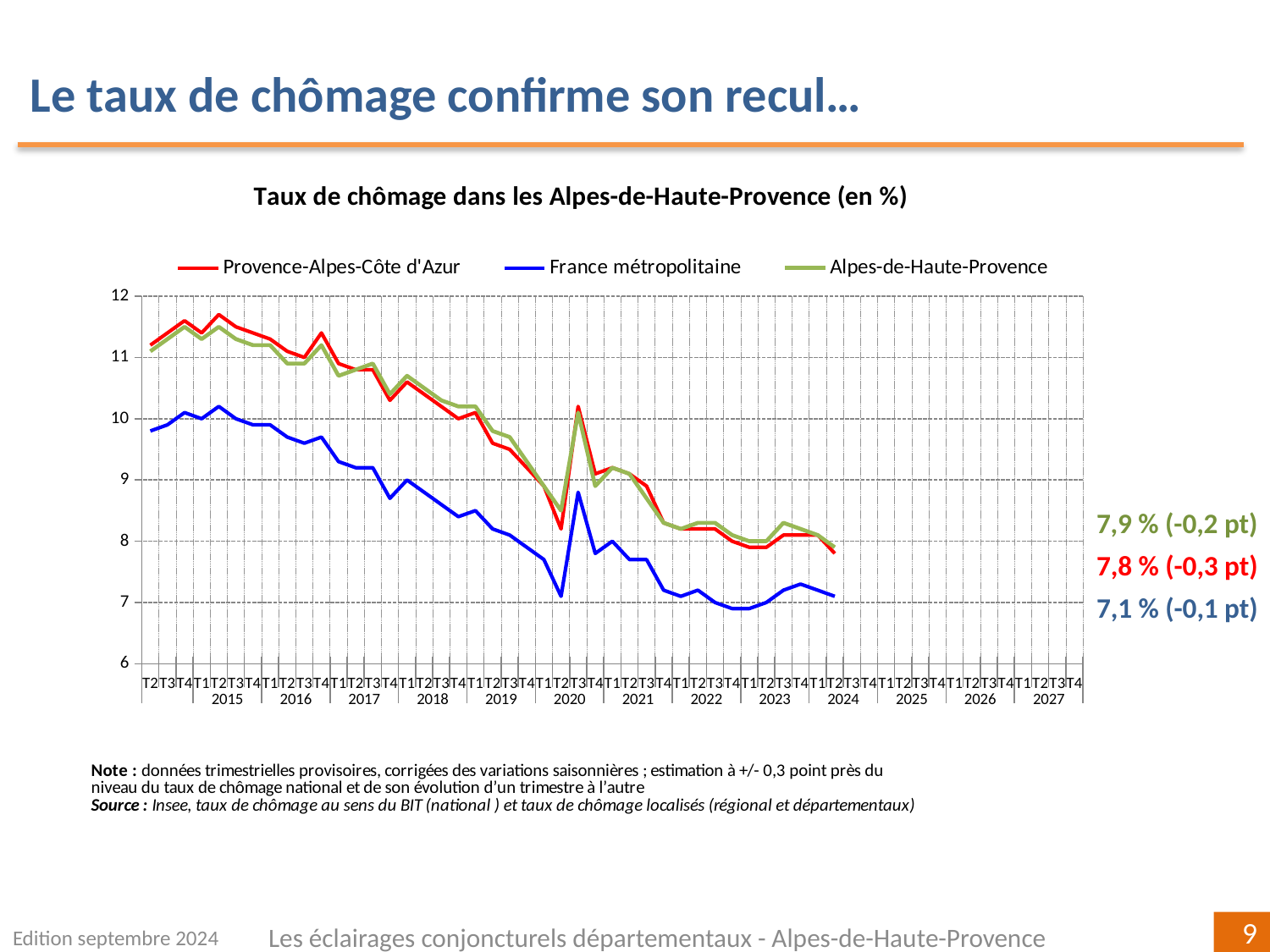
By how much did the Provence-Alpes-Côte d'Azur rate change in the latest quarter, according to the annotation? -0,3 pt Is the value for France métropolitaine in 2015 greater or less than 11? less At the latest point, which series has the higher rate: Provence-Alpes-Côte d'Azur or France métropolitaine? Provence-Alpes-Côte d'Azur What is the latest unemployment rate shown for Alpes-de-Haute-Provence? 7,9 % What is the latest unemployment rate shown for France métropolitaine? 7,1 % Overall, do the unemployment rates rise or fall from 2015 to 2024? fall Which series is the lowest across the whole period shown? France métropolitaine What kind of chart is shown on the slide? line chart What is the title of the chart? Taux de chômage dans les Alpes-de-Haute-Provence (en %) What is the difference between the latest rates for Alpes-de-Haute-Provence and France métropolitaine? 0,8 points What is the latest unemployment rate shown for Provence-Alpes-Côte d'Azur? 7,8 % How many series does the legend list? 3